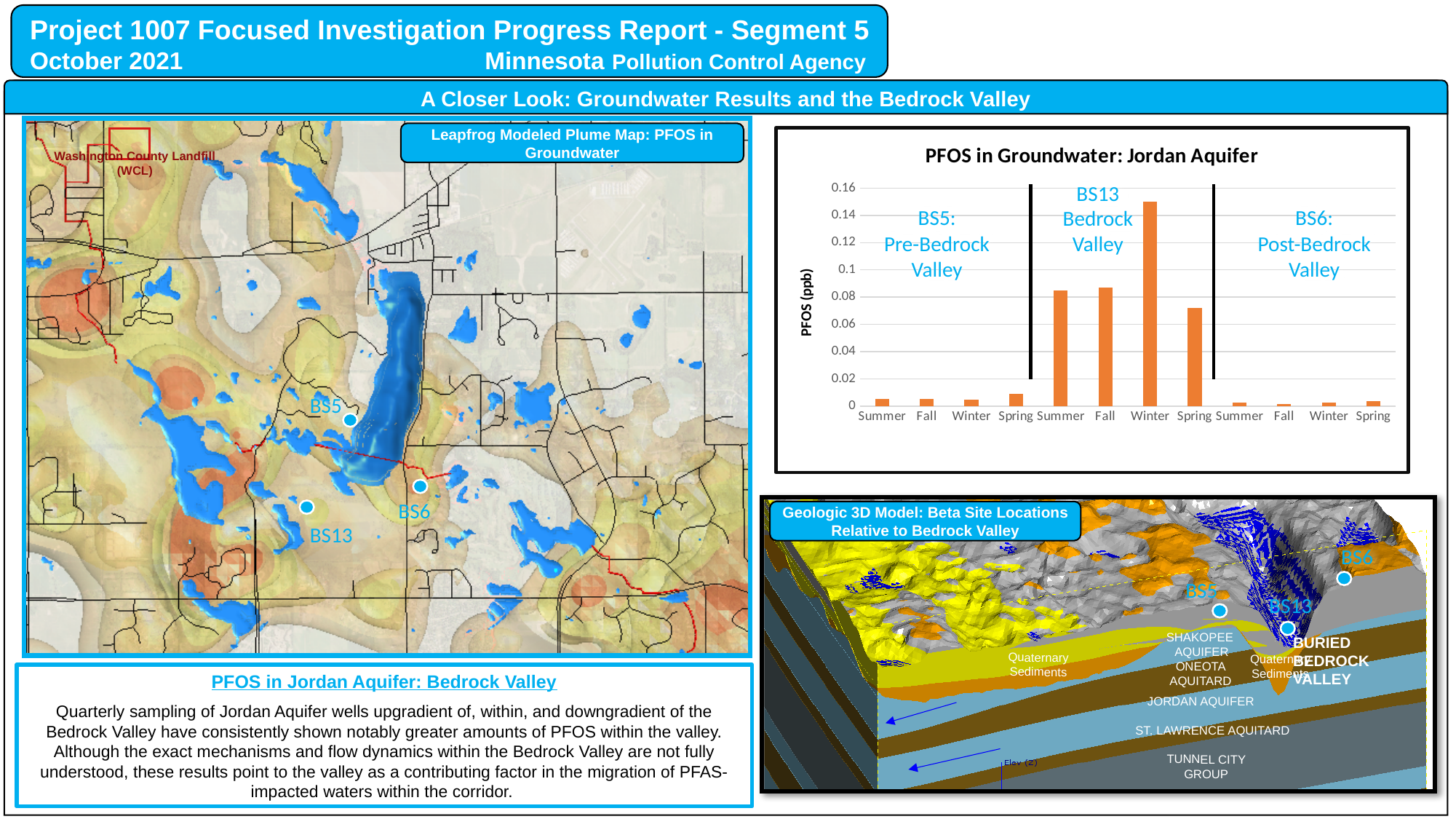
In the "PFOS in Groundwater: Jordan Aquifer" chart, is the Spring value for BS5 Pre-Bedrock Valley greater or less than 0.02? less What is the y-axis label of the "PFOS in Groundwater: Jordan Aquifer" chart? PFOS (ppb) How many bars are plotted in the "PFOS in Groundwater: Jordan Aquifer" chart? 12 In the "PFOS in Groundwater: Jordan Aquifer" chart, which of the three well groups has the highest PFOS values? BS13: Bedrock Valley What is the highest value shown on the y-axis of the "PFOS in Groundwater: Jordan Aquifer" chart? 0.16 In the "PFOS in Groundwater: Jordan Aquifer" chart, which is larger: the BS13 Winter value or the BS13 Spring value? BS13 Winter In the "PFOS in Groundwater: Jordan Aquifer" chart, is the Winter value for BS13 Bedrock Valley greater or less than 0.14? greater What kind of chart is "PFOS in Groundwater: Jordan Aquifer"? bar chart In the "PFOS in Groundwater: Jordan Aquifer" chart, which is larger: the BS13 Spring value or the BS5 Spring value? BS13 Spring In the "PFOS in Groundwater: Jordan Aquifer" chart, is the Spring value for BS13 Bedrock Valley greater or less than 0.08? less In the "PFOS in Groundwater: Jordan Aquifer" chart, which bar is the highest? BS13 Winter